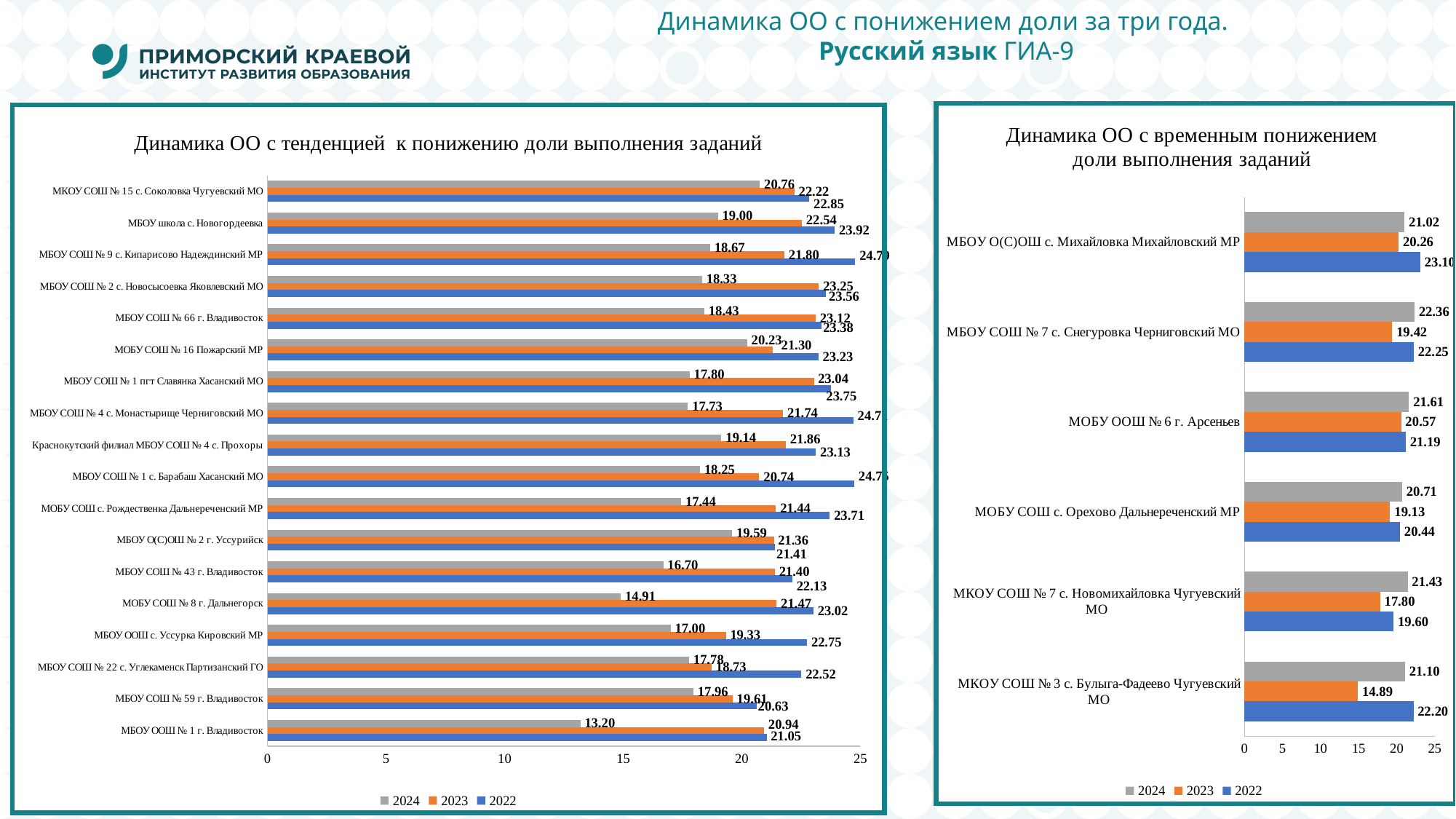
In the left chart, how many schools (categories) are shown? 18 In the right chart, which school has the highest 2024 value? МБОУ СОШ № 7 с. Снегуровка Черниговский МО In the right chart 'Динамика ОО с временным понижением доли выполнения заданий', what is the 2023 value for МКОУ СОШ № 3 с. Булыга-Фадеево Чугуевский МО? 14.89 In the left chart, which school has the lowest 2024 value? МБОУ ООШ № 1 г. Владивосток What type of chart is the right chart? bar chart How many series does the legend of the right chart list? 3 In the left chart, what is the difference between the 2022 and 2024 values for МБОУ СОШ № 43 г. Владивосток? 5.43 In the left chart, is the 2024 value for МОБУ СОШ № 8 г. Дальнегорск greater or less than 15? less In the left chart, what is the 2022 value for МОБУ СОШ № 8 г. Дальнегорск? 23.02 In the right chart, which school has the lowest 2023 value? МКОУ СОШ № 3 с. Булыга-Фадеево Чугуевский МО In the left chart 'Динамика ОО с тенденцией к понижению доли выполнения заданий', what is the 2024 value for МБОУ ООШ № 1 г. Владивосток? 13.20 In the right chart, which is larger for МОБУ ООШ № 6 г. Арсеньев: the 2024 value or the 2022 value? 2024